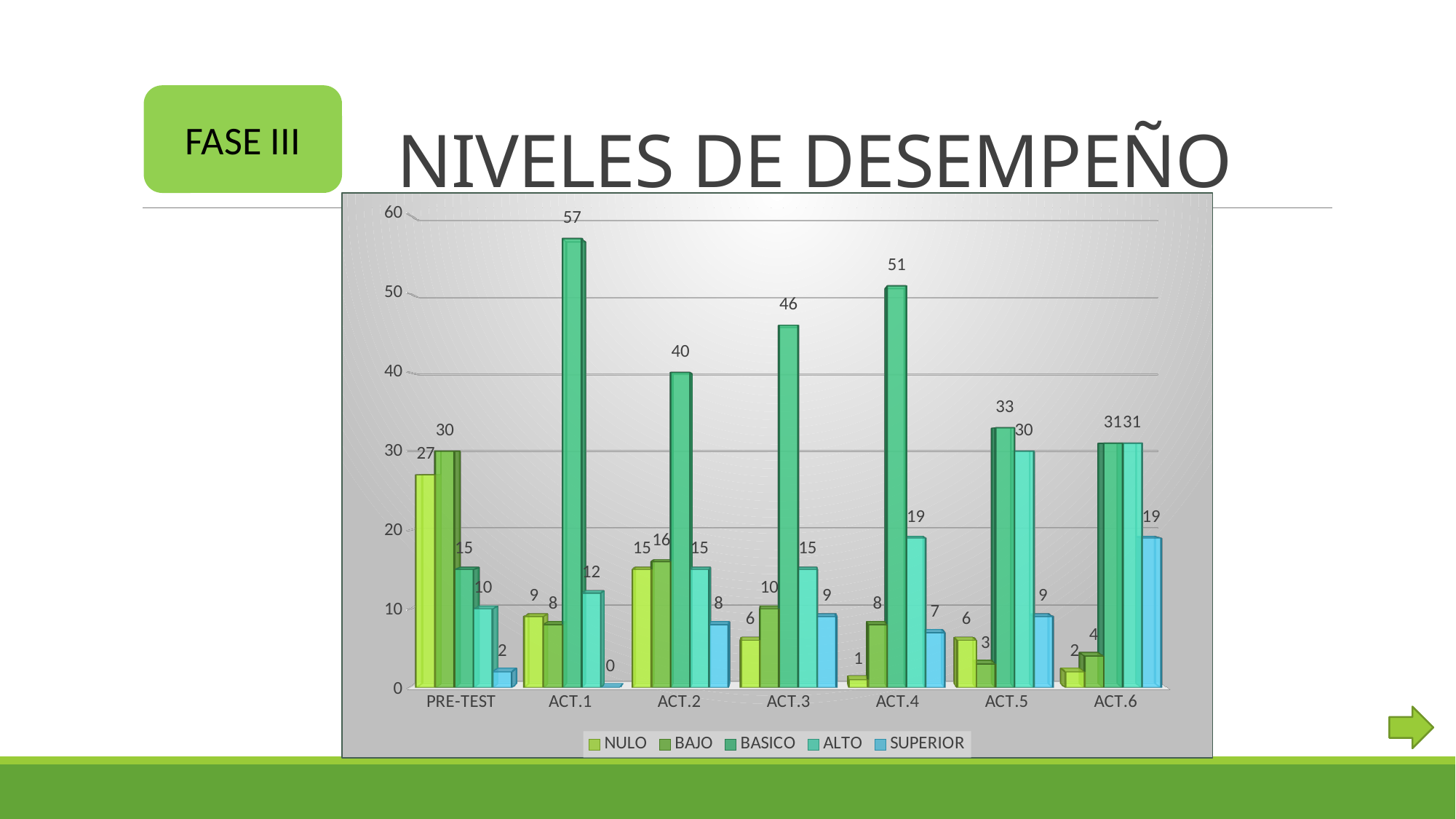
What is the title of the slide containing the chart? NIVELES DE DESEMPEÑO What kind of chart is shown on the slide? bar chart Which category has the highest BASICO value? ACT.1 Which category has the lowest NULO value? ACT.4 What is the ALTO value for ACT.5? 30 How many series does the legend list? 5 What is the NULO value for PRE-TEST? 27 What is the difference between the BASICO values for ACT.1 and ACT.2? 17 How many categories are shown on the x axis? 7 What is the SUPERIOR value for ACT.6? 19 What is the BASICO value for ACT.1? 57 Which is larger, the ALTO value for ACT.4 or the ALTO value for ACT.3? ACT.4